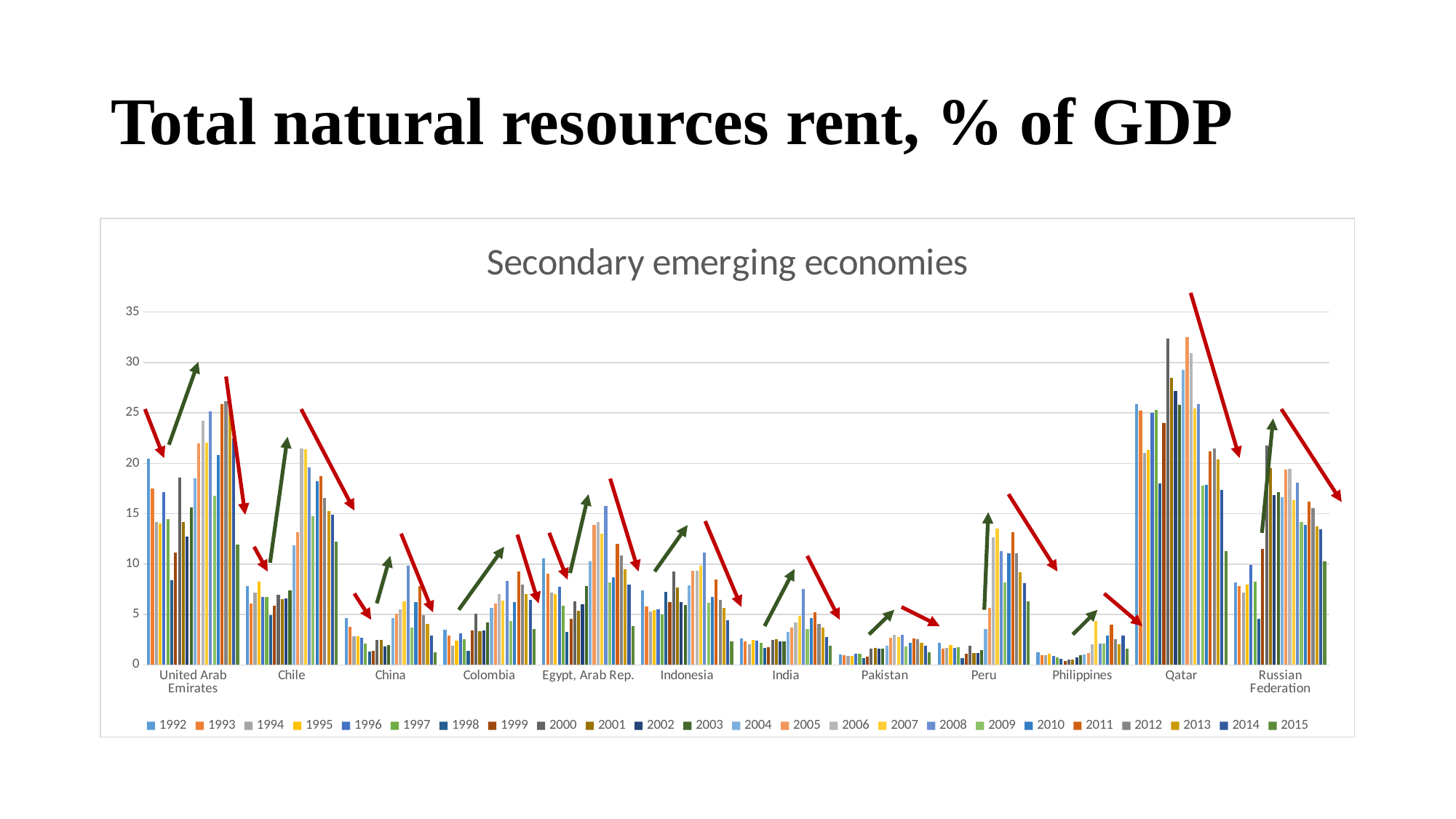
Is the tallest bar for Qatar greater or less than 30? greater What type of chart is shown on the slide? Bar chart Which country has the tallest bars in the chart? Qatar Which country has taller bars overall, Qatar or Pakistan? Qatar Are all the bars for Pakistan greater or less than 5? less How many series (years) does the chart legend list? 24 How many countries (categories) are shown on the x axis of the chart? 12 What is the title of the chart? Secondary emerging economies Are all the bars for Philippines greater or less than 10? less What is the first year listed in the chart legend? 1992 Which country has taller bars overall, Russian Federation or India? Russian Federation